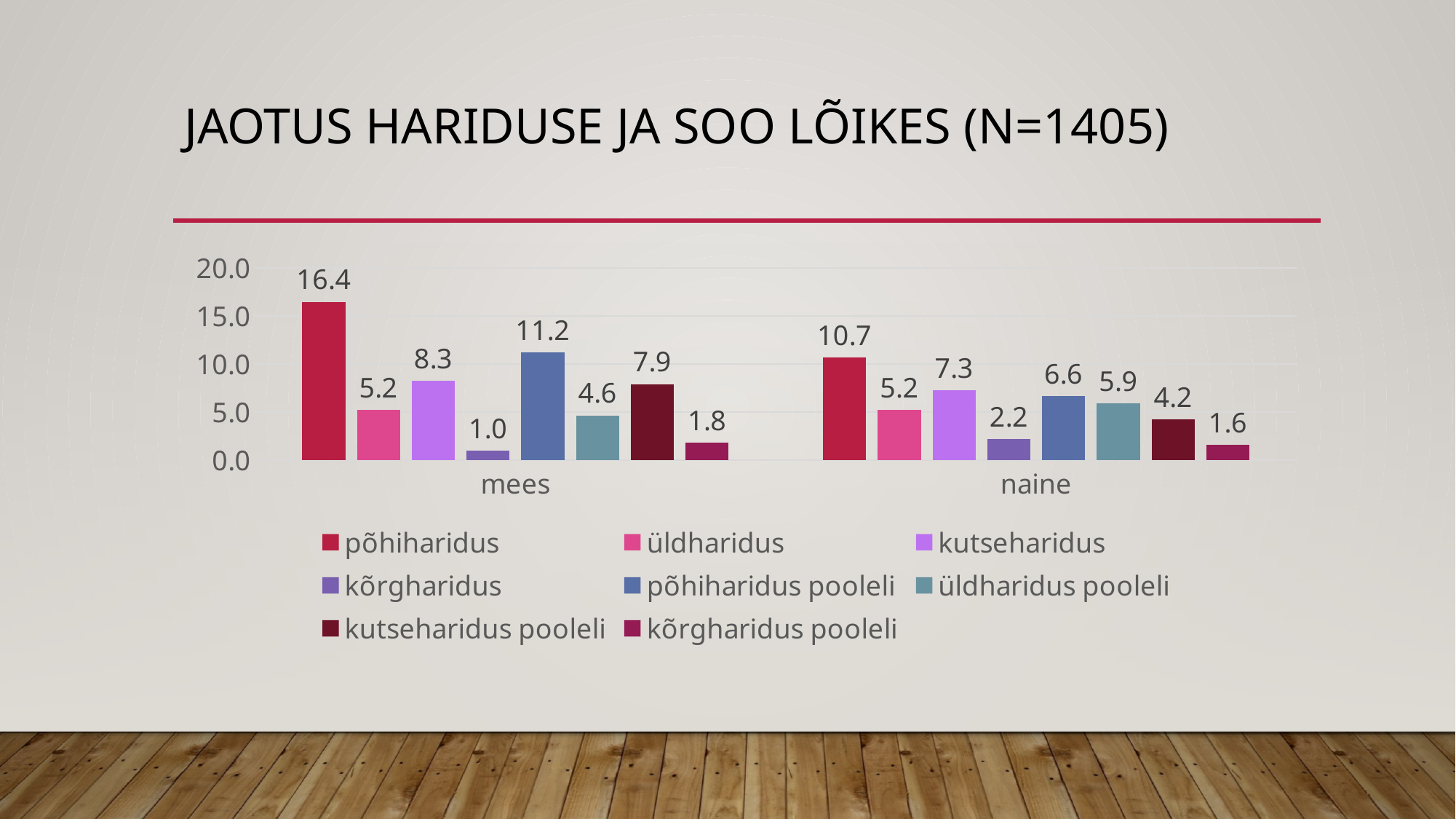
Which series has the highest value in the naine group? põhiharidus Which is larger: kutseharidus pooleli for mees or for naine? mees What kind of chart is shown on the slide? bar chart What is the value for põhiharidus in the mees group? 16.4 What is the value for põhiharidus pooleli in the mees group? 11.2 Is the value for põhiharidus pooleli in the mees group greater or less than 10.0? greater How many categories are shown on the x axis? 2 Which series has the lowest value in the mees group? kõrgharidus How many series does the legend list? 8 What is the value for kõrgharidus in the naine group? 2.2 What is the title of the chart on the slide? JAOTUS HARIDUSE JA SOO LÕIKES (N=1405) What is the difference between the põhiharidus values for mees and naine? 5.7